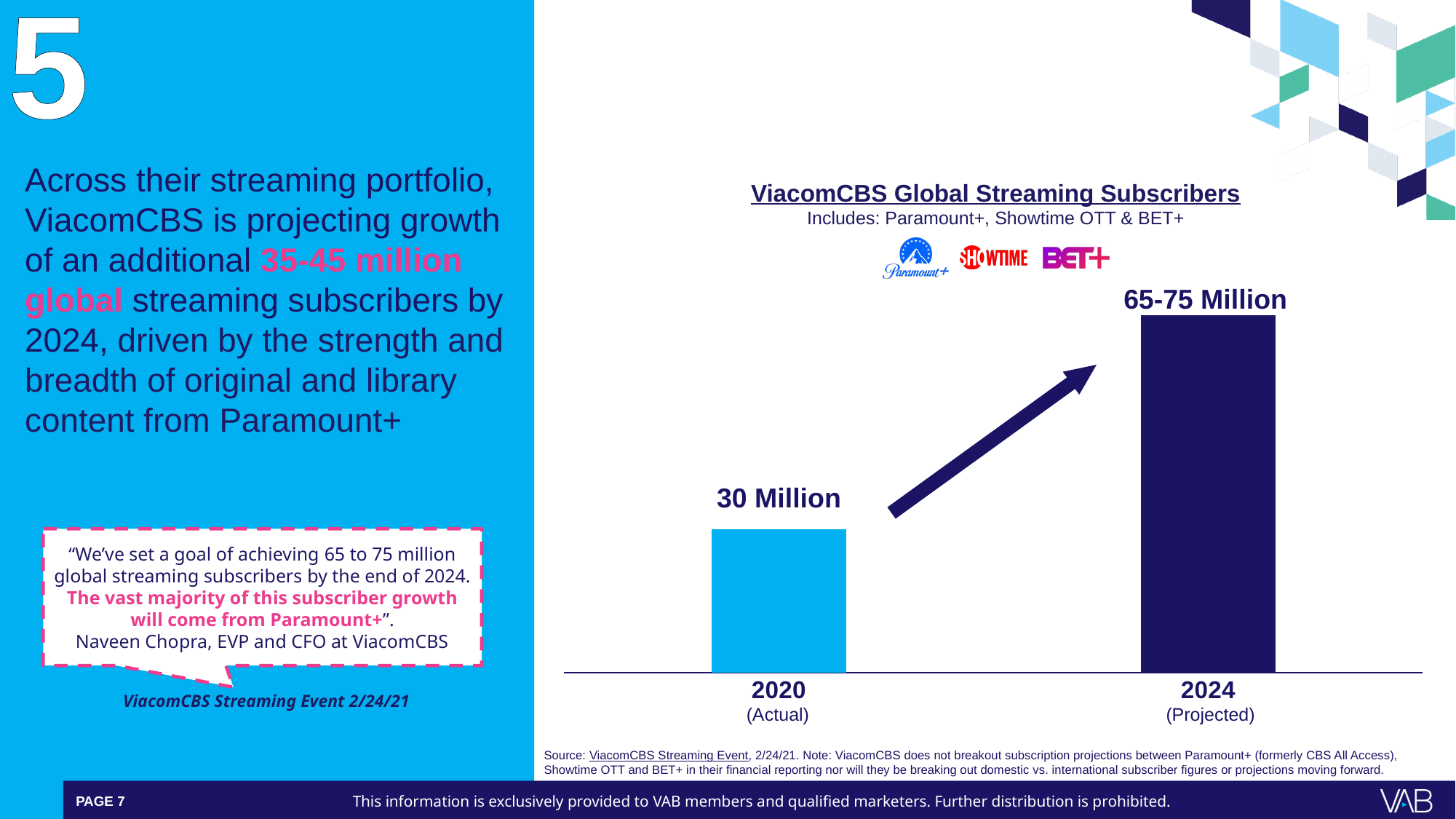
Which bar in the chart is labeled as projected rather than actual? 2024 What is the value shown for 2024 (Projected) in the ViacomCBS Global Streaming Subscribers chart? 65-75 Million Do the values in the ViacomCBS Global Streaming Subscribers chart rise or fall from 2020 to 2024? rise What kind of chart is used to show ViacomCBS Global Streaming Subscribers? bar chart Which three services does the chart subtitle say are included in the subscriber figures? Paramount+, Showtime OTT & BET+ Which year has the higher bar in the ViacomCBS Global Streaming Subscribers chart? 2024 What is the title of the chart on the slide? ViacomCBS Global Streaming Subscribers Which year has the lower bar in the ViacomCBS Global Streaming Subscribers chart? 2020 Is the bar for 2024 (Projected) larger or smaller than the bar for 2020 (Actual)? larger How many bars are plotted in the ViacomCBS Global Streaming Subscribers chart? 2 What is the value shown for 2020 (Actual) in the ViacomCBS Global Streaming Subscribers chart? 30 Million